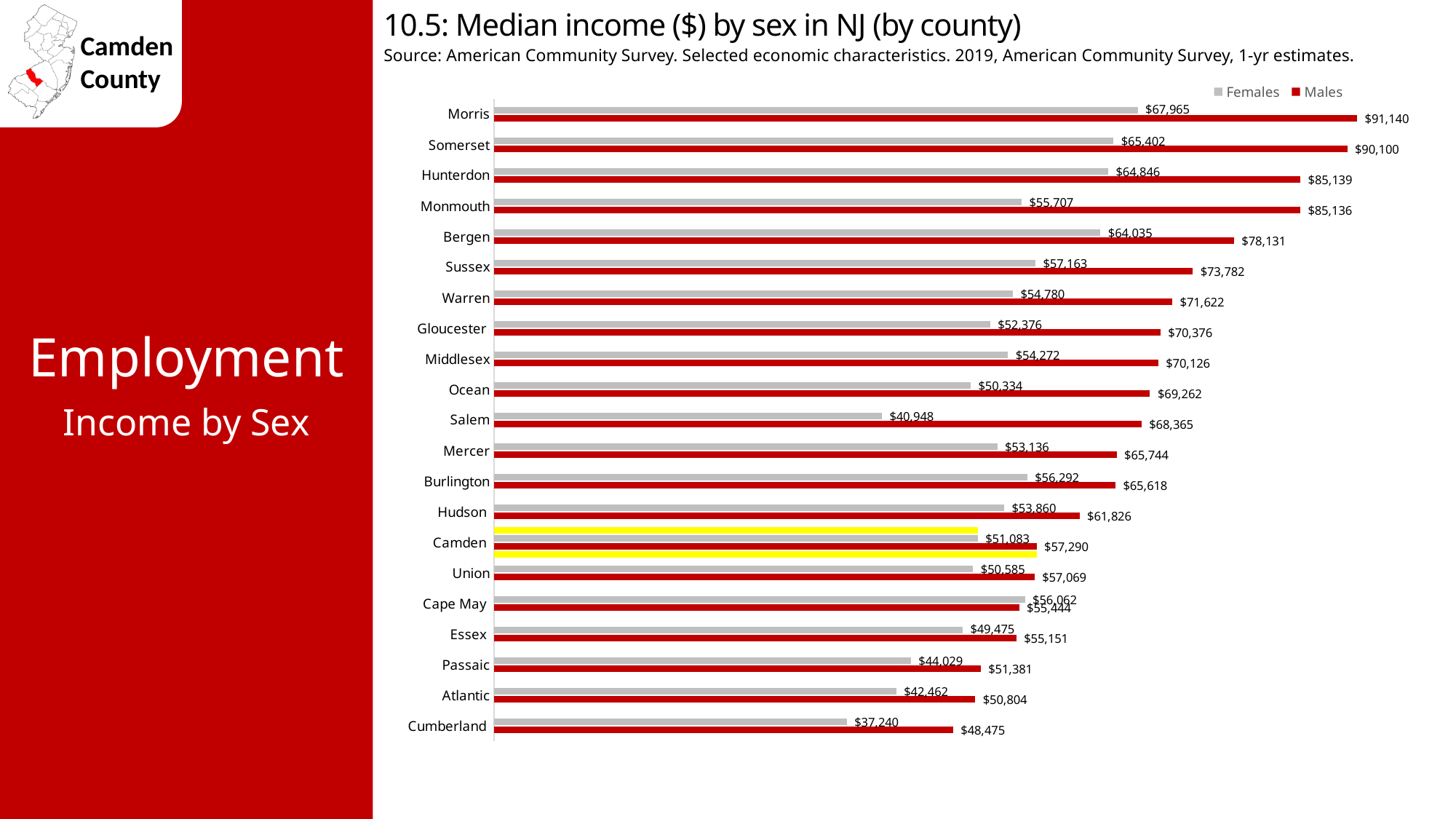
What is the median income for males in Bergen County? $78,131 What type of chart is used to show median income by sex? Bar chart In Cape May County, which is higher: the female or the male median income? Females How many series does the legend list? 2 What is the median income for males in Camden County? $57,290 What is the median income for females in Salem County? $40,948 Which county has the lowest median income for females? Cumberland How many counties are shown in the chart? 21 Which county has the highest median income for males? Morris What is the difference between the male and female median income in Camden County? $6,207 Which is higher: the female median income in Hunterdon County or in Bergen County? Hunterdon What is the difference between the male median income in Morris County and in Somerset County? $1,040